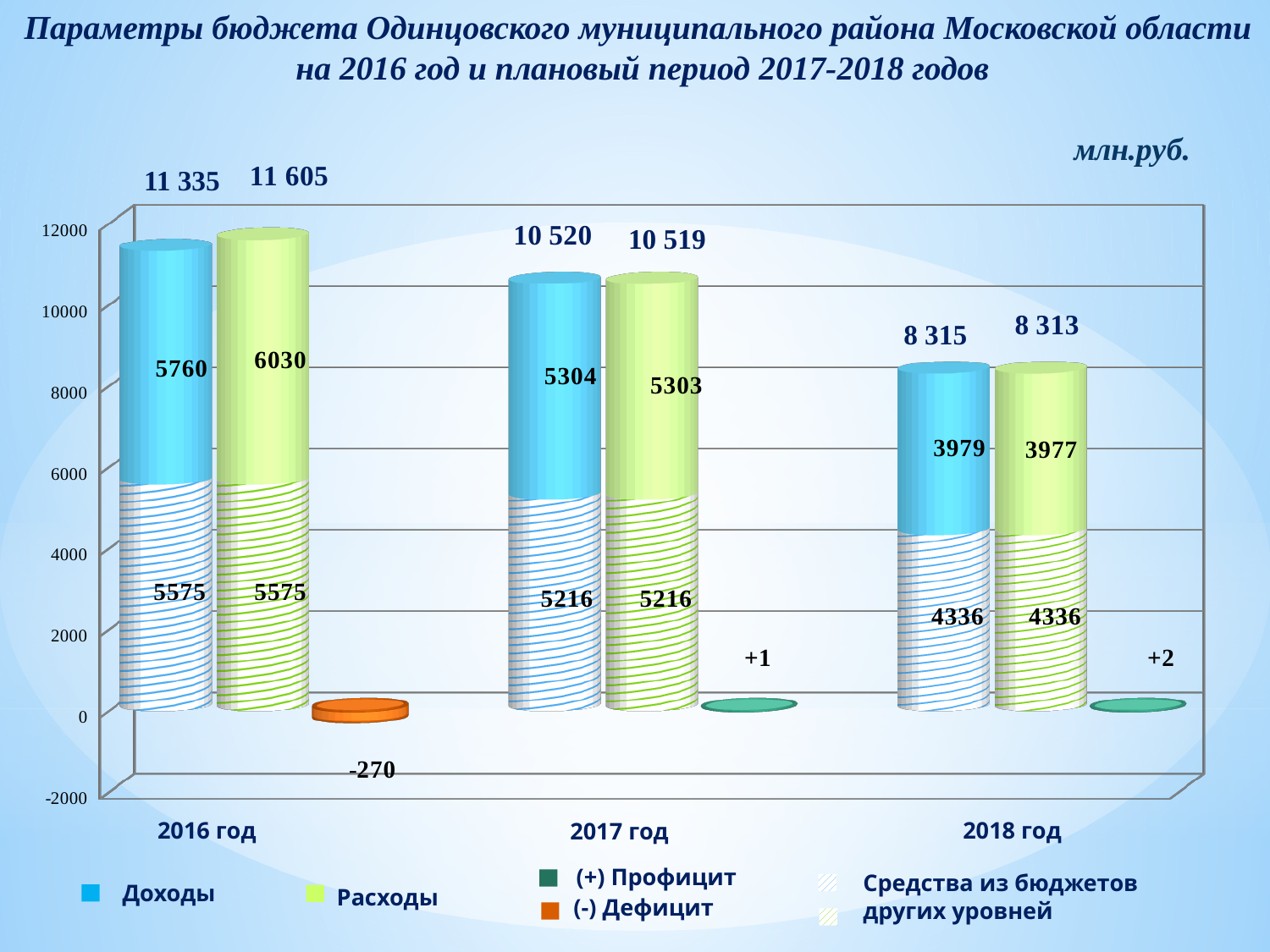
What is the total value of Доходы (income) for 2016 год? 11 335 What unit of measurement is indicated on the slide for the chart values? млн.руб. How many years are shown on the x axis? 3 What is the difference between total Расходы and total Доходы in 2016 год? 270 What is the deficit value shown for 2016 год? -270 In which year is the total Доходы (income) highest? 2016 год In which year is the total Расходы (expenses) lowest? 2018 год What is the total value of Расходы (expenses) for 2017 год? 10 519 What is the value of the upper (own) portion of the Расходы bar for 2016 год? 6030 What is the surplus value shown for 2018 год? +2 What is the value of the Средства из бюджетов других уровней portion of the Доходы bar for 2018 год? 4336 Which is larger in 2017 год: total Доходы or total Расходы? Доходы